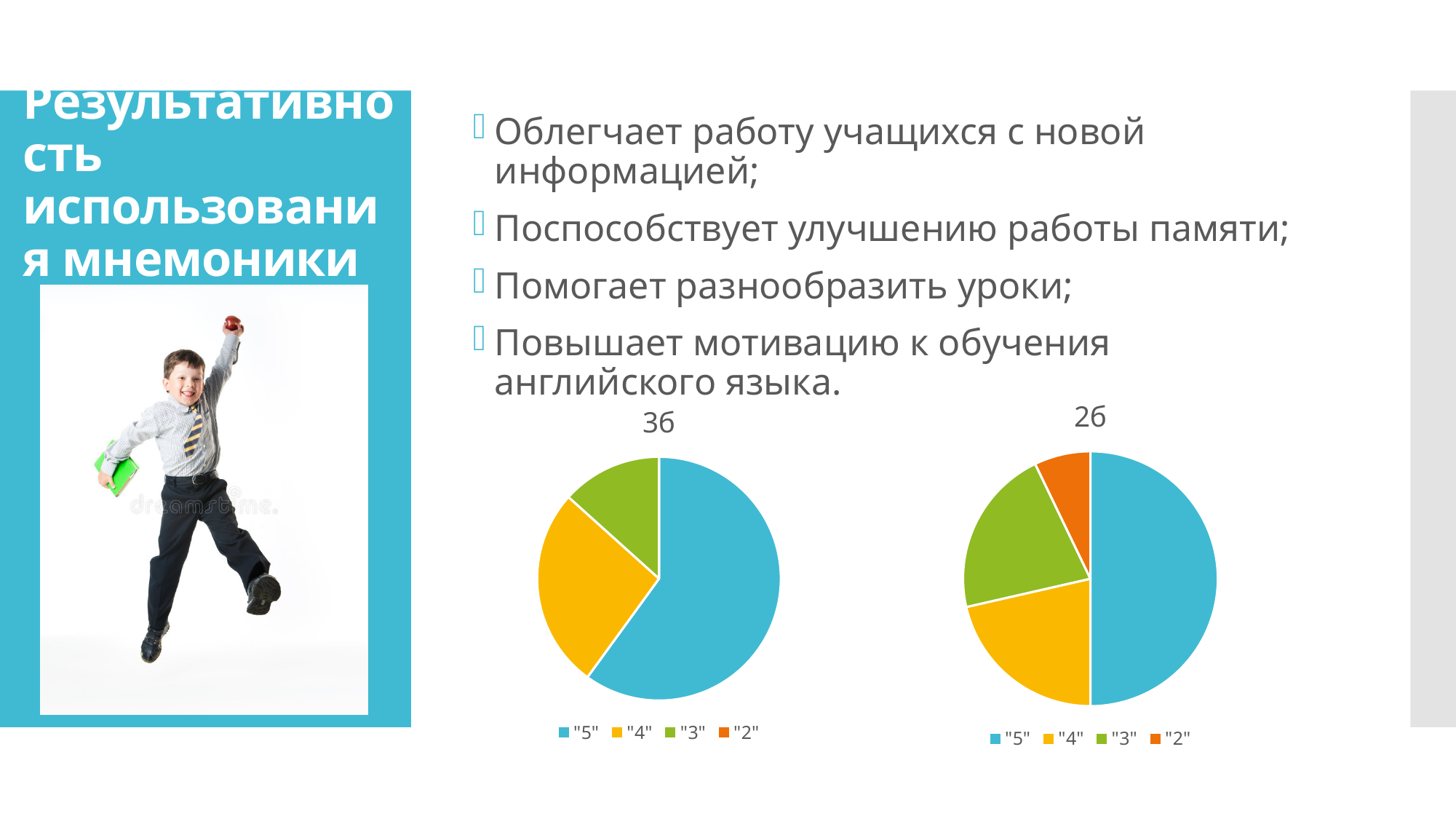
In the chart titled 3б, which grade has the largest slice? "5" How many slices are visible in the chart titled 2б? 4 How many slices are visible in the chart titled 3б? 3 In the chart titled 2б, which slice is larger, "4" or "2"? "4" In the chart titled 2б, which grade has the smallest slice? "2" How many entries does the legend of the chart titled 3б list? 4 In the chart titled 3б, which slice is larger, "5" or "4"? "5" What is the title of the pie chart on the right side of the slide? 2б What kind of chart is the chart titled 3б? pie chart What kind of chart is the chart titled 2б? pie chart In the chart titled 2б, which slice is larger, "5" or "3"? "5" In the chart titled 2б, which grade has the largest slice? "5"